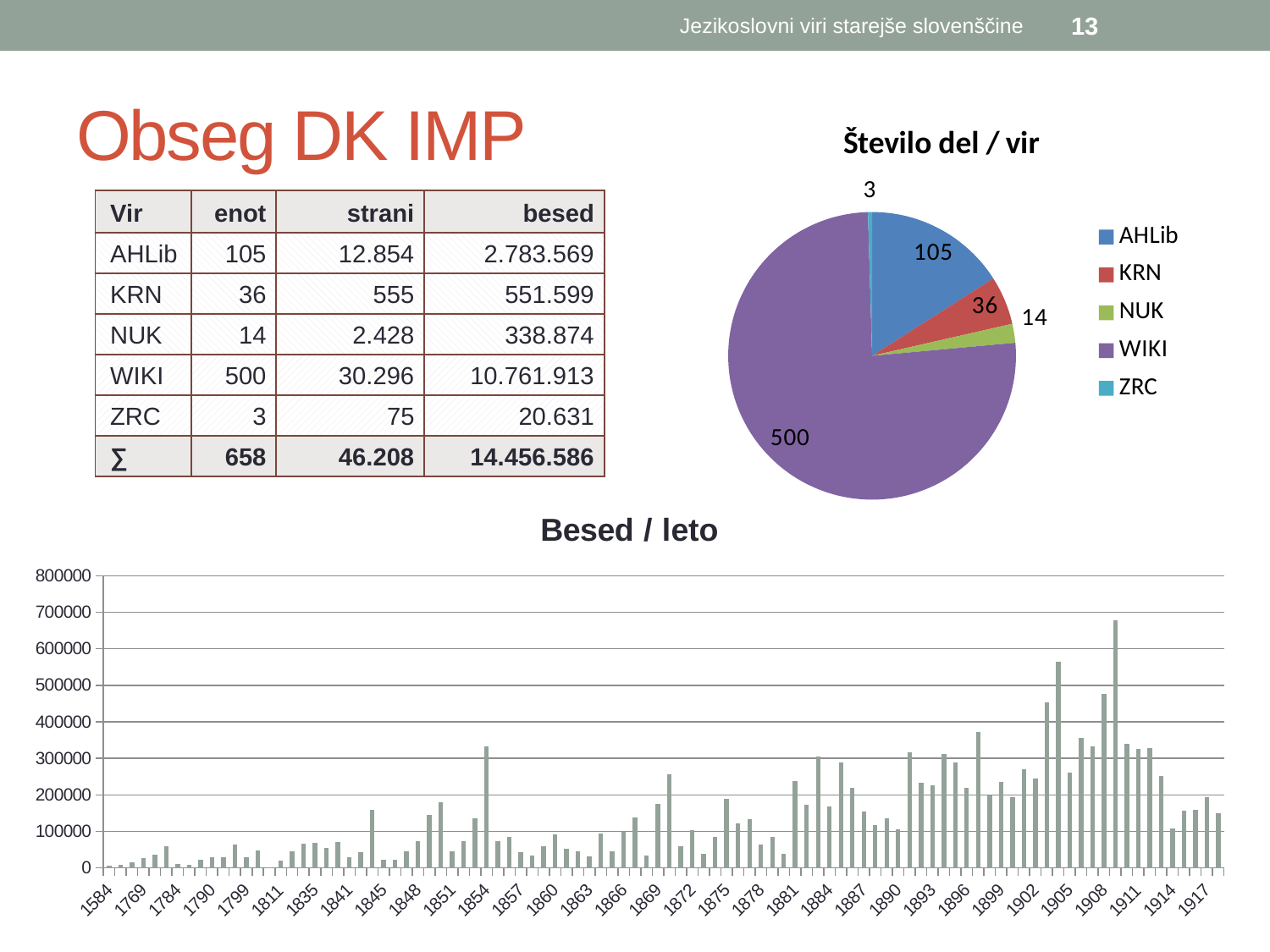
In the 'Besed / leto' chart, is the tallest bar greater or less than 600000? greater In the 'Število del / vir' pie chart, what value is shown for KRN? 36 How many slices does the 'Število del / vir' pie chart have? 5 In the 'Število del / vir' pie chart, what value is shown for AHLib? 105 In the 'Število del / vir' pie chart, what is the difference between the values for WIKI and AHLib? 395 In the 'Število del / vir' pie chart, which source has the largest slice? WIKI In the 'Besed / leto' chart, is the value for 1584 greater or less than 100000? less In the 'Število del / vir' pie chart, what value is shown for WIKI? 500 How many entries does the legend of the 'Število del / vir' chart list? 5 What kind of chart is 'Besed / leto'? bar chart In the 'Število del / vir' pie chart, which source has the smallest slice? ZRC In the 'Število del / vir' pie chart, which is larger, the value for KRN or the value for NUK? KRN